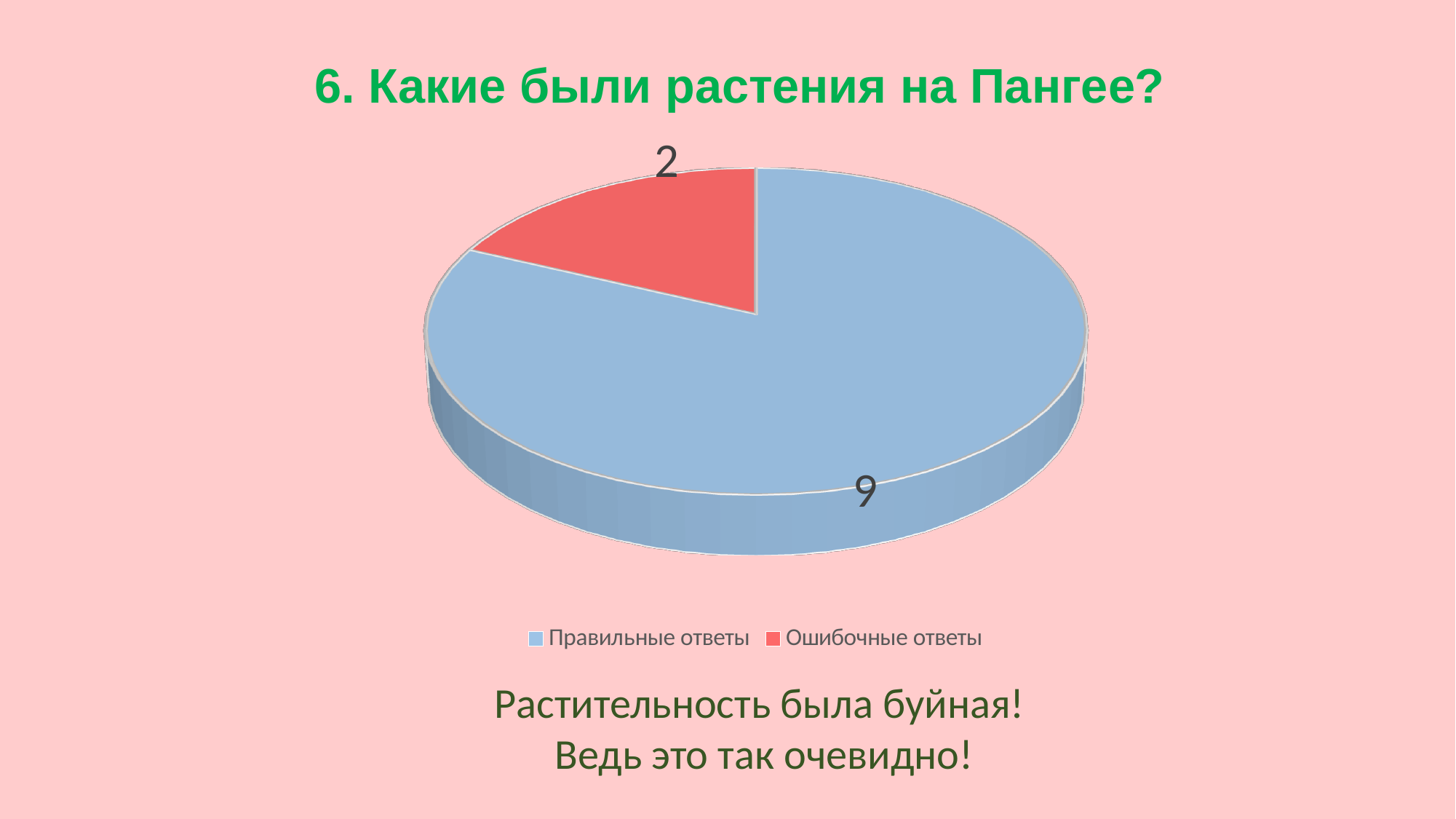
Which is larger, Правильные ответы or Ошибочные ответы? Правильные ответы Which category has the smallest slice? Ошибочные ответы How many slices does the pie chart have? 2 What colour is the slice for Ошибочные ответы? Red What type of chart is shown on the slide? Pie chart What is the value for Ошибочные ответы? 2 What colour is the slice for Правильные ответы? Blue What is the value for Правильные ответы? 9 What is the total of all slices in the pie chart? 11 Which category has the largest slice? Правильные ответы What is the difference between Правильные ответы and Ошибочные ответы? 7